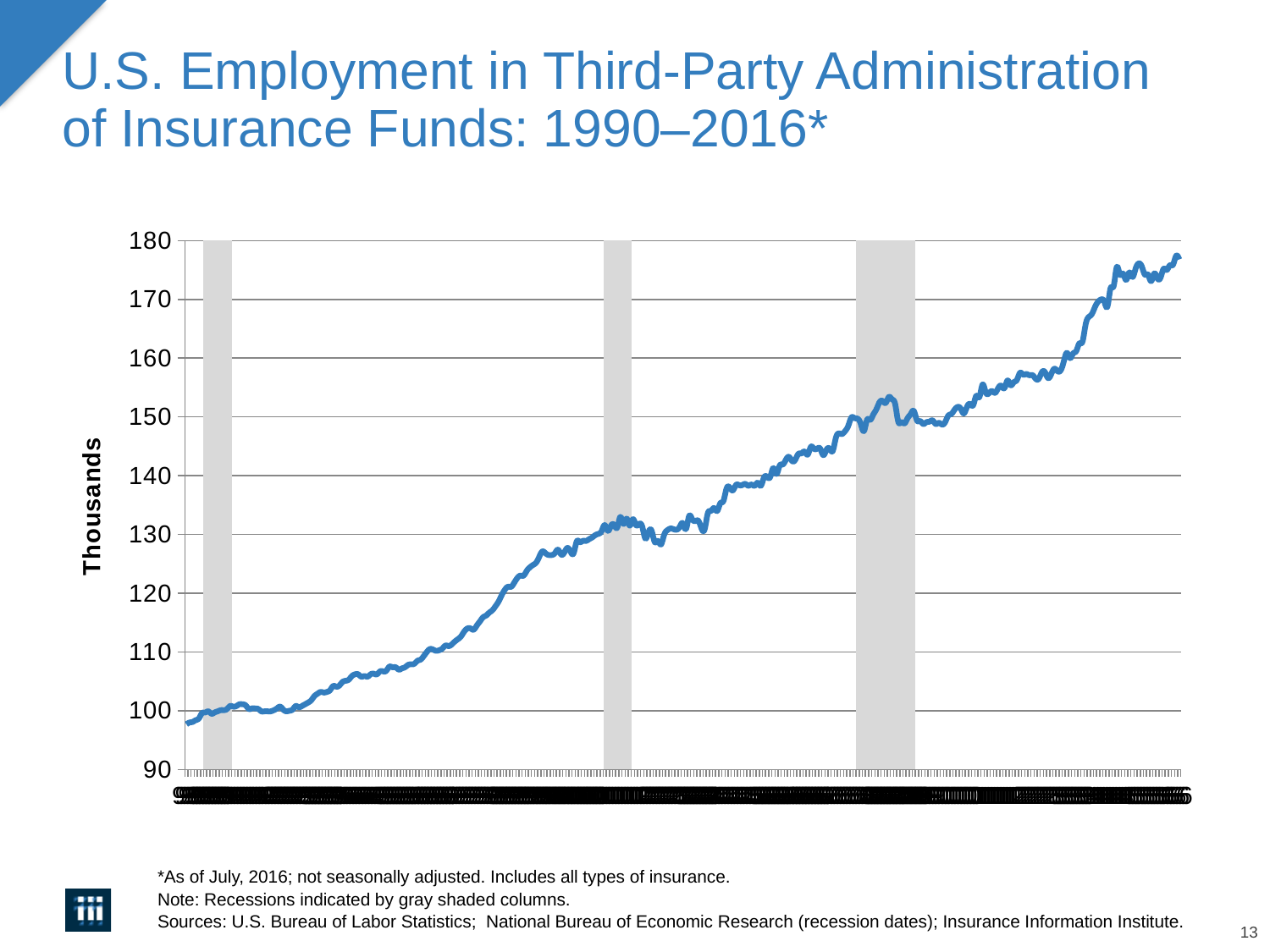
How many gray shaded recession columns are shown on the chart? 3 Is the value at the left end of the line (1990) greater or less than 110? less Is the value at the right end of the line (July 2016) greater or less than 170? greater Which end of the line is higher, the left end (1990) or the right end (2016)? the right end (2016) Is the highest point on the line greater or less than 170? greater What is the highest value shown on the vertical axis? 180 What kind of chart is shown on the slide? line chart What is the label on the vertical axis? Thousands Overall, do the values rise or fall from left to right along the x axis? rise